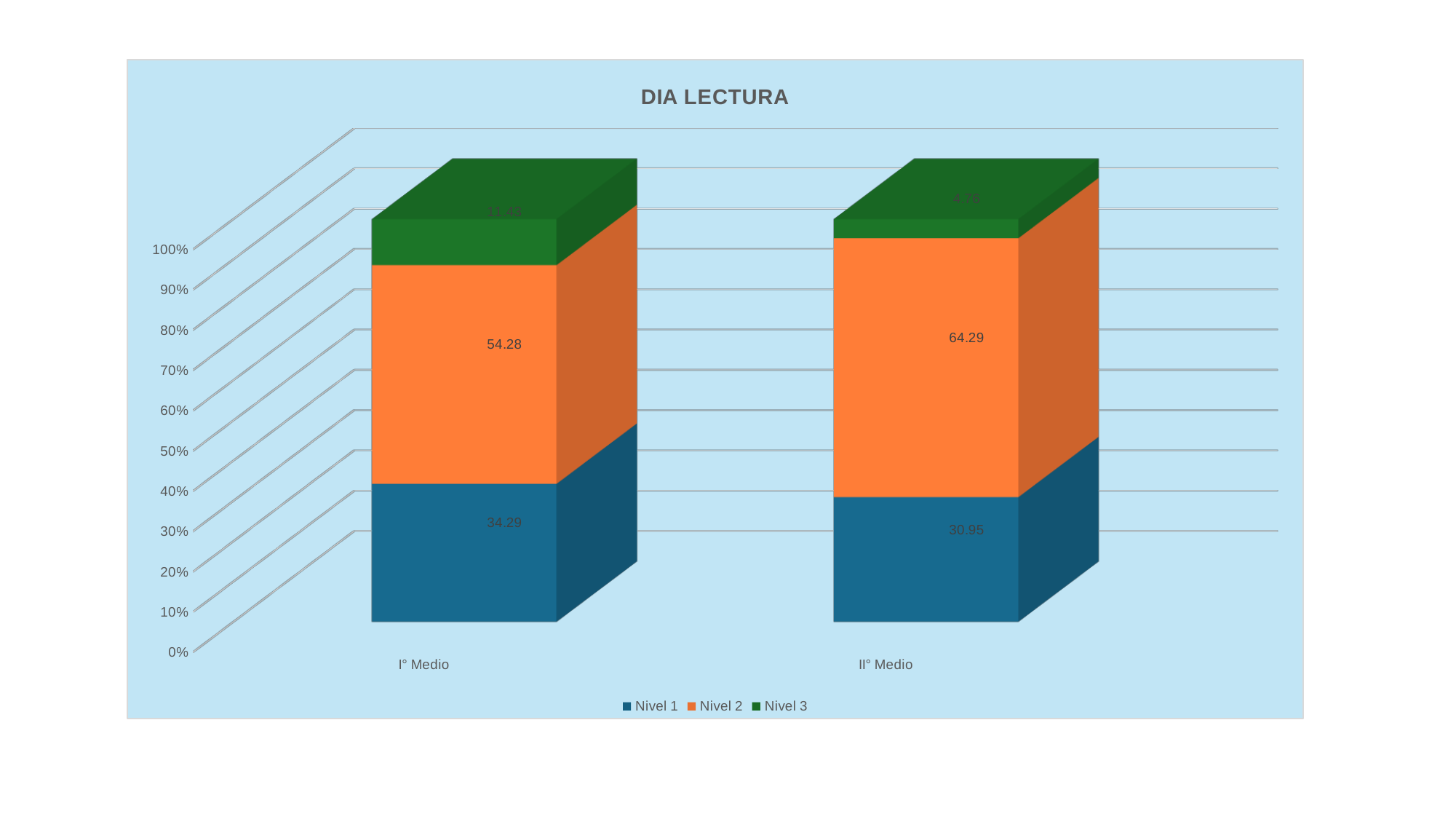
Which category has the lower value for Nivel 3? II° Medio What kind of chart is shown? Stacked bar chart What is the value of Nivel 3 for II° Medio? 4.76 Is the Nivel 1 value for I° Medio or for II° Medio larger? I° Medio What is the title of the chart? DIA LECTURA What is the difference between the Nivel 2 values for II° Medio and I° Medio? 10.01 What is the value of Nivel 2 for I° Medio? 54.28 How many categories are shown on the x axis? 2 How many series does the legend list? 3 What is the value of Nivel 1 for II° Medio? 30.95 Which category has the higher value for Nivel 2? II° Medio What is the value of Nivel 3 for I° Medio? 11.43